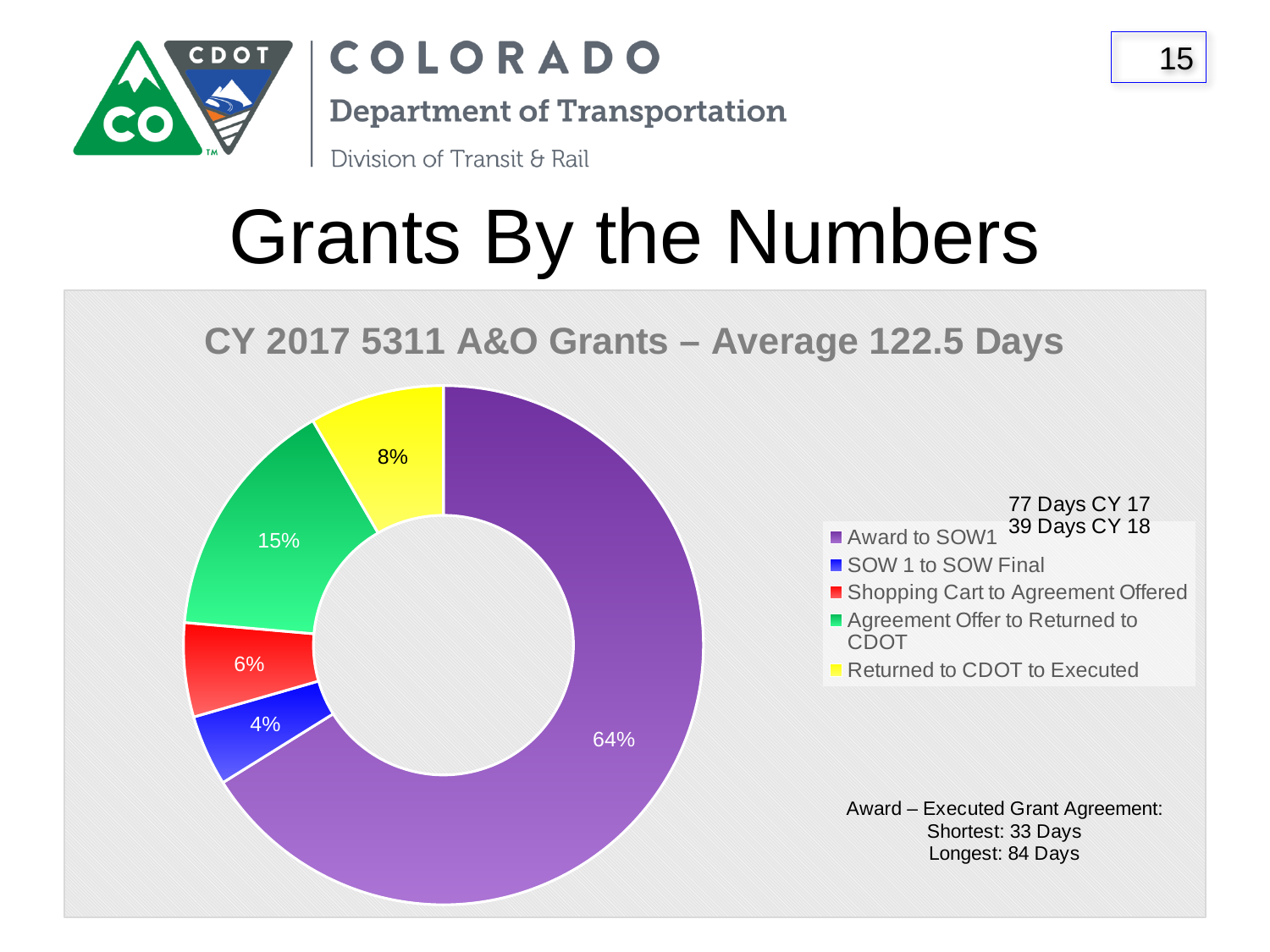
What percentage of the chart does Award to SOW1 represent? 64% What percentage is shown for SOW 1 to SOW Final? 4% Which is larger, the share for Shopping Cart to Agreement Offered or the share for SOW 1 to SOW Final? Shopping Cart to Agreement Offered What percentage is shown for Shopping Cart to Agreement Offered? 6% What is the title of the chart? CY 2017 5311 A&O Grants – Average 122.5 Days What is the difference in percentage points between Agreement Offer to Returned to CDOT and Returned to CDOT to Executed? 7 percentage points What type of chart is shown on the slide? Doughnut chart Which category has the smallest share of the chart? SOW 1 to SOW Final Which category has the largest share of the chart? Award to SOW1 What percentage is shown for Returned to CDOT to Executed? 8% What percentage is shown for Agreement Offer to Returned to CDOT? 15% How many categories does the legend list? 5